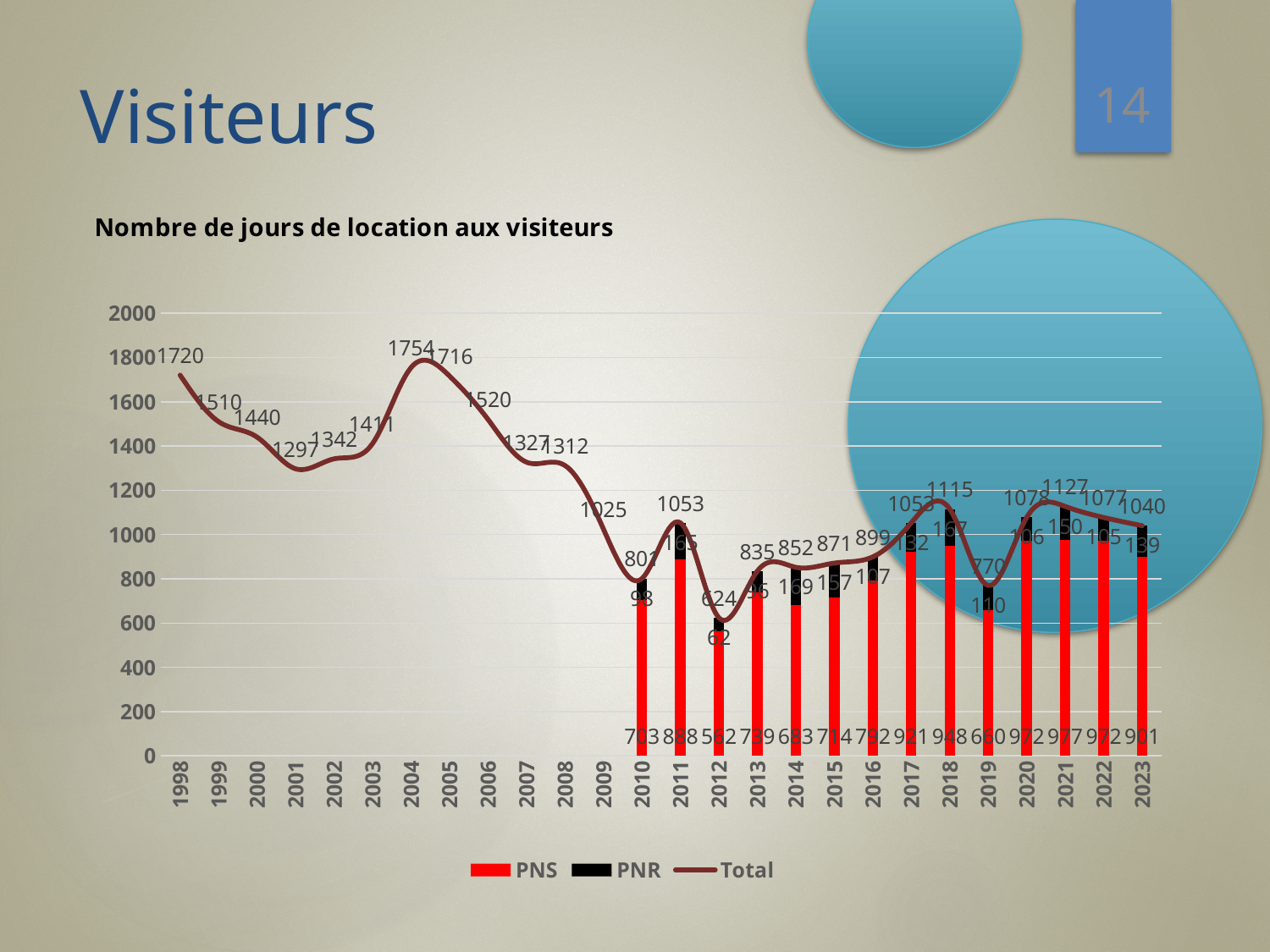
In which year is the Total lowest? 2012 What is the Total value for 1998? 1720 In which year is the Total highest? 2004 How many series does the legend list? 3 What is the PNS value for 2011? 888 What is the difference between the PNS value for 2017 and the PNS value for 2019? 261 Does the Total rise or fall from 1998 to 2001? Fall What is the difference between the Total for 2004 and the Total for 2005? 38 Which year has the larger Total, 2018 or 2021? 2021 How many years are shown on the x axis? 26 What kind of chart is shown? Combined bar and line chart What is the PNR value for 2012? 62